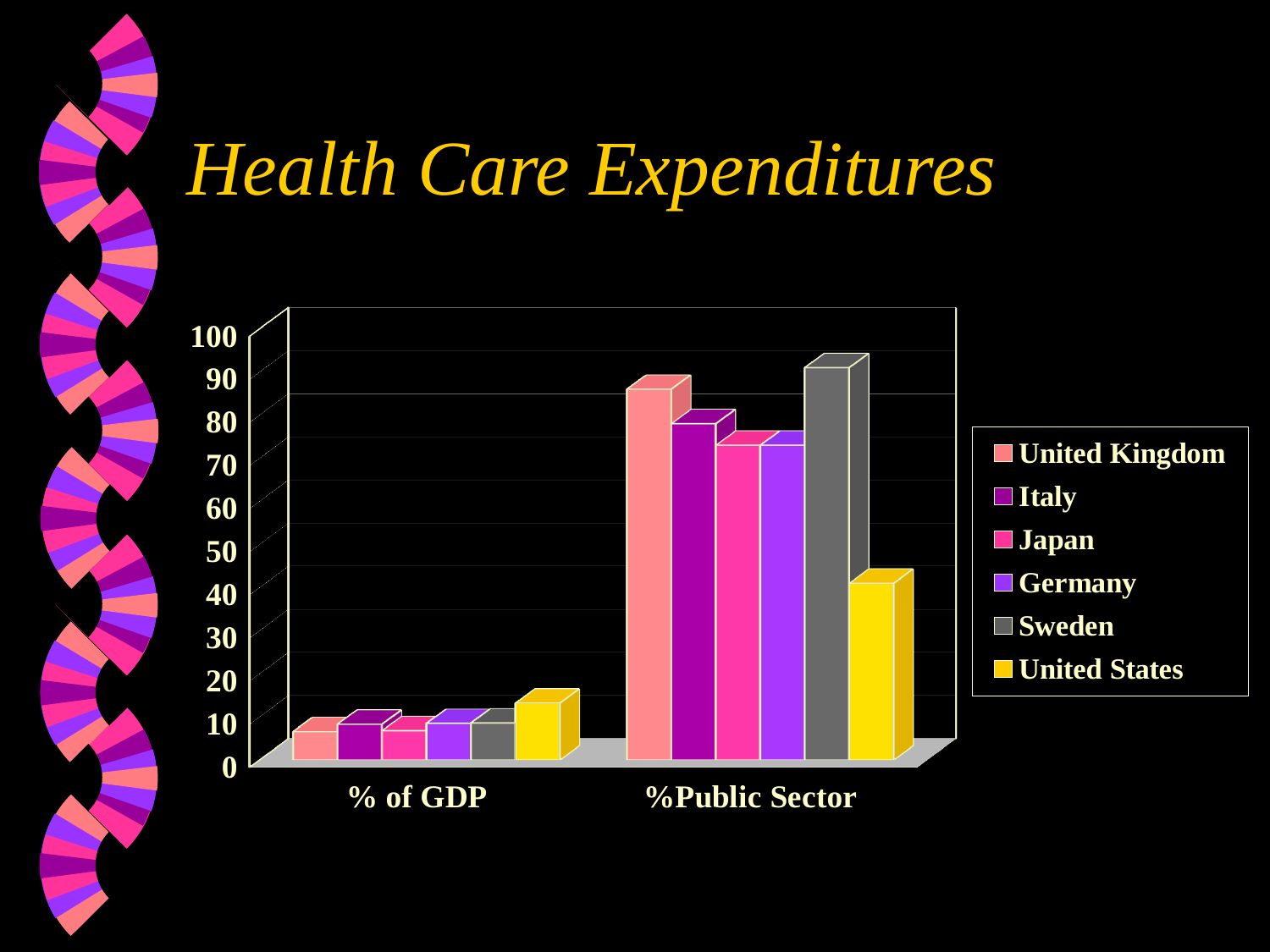
Which is larger for %Public Sector: the United Kingdom or the United States? United Kingdom Is the value for Sweden in %Public Sector greater or less than 80? greater Which country has the lowest value for %Public Sector? United States How many series does the legend list? 6 How many categories are shown on the x axis of the chart? 2 Which country has the highest value for % of GDP? United States What kind of chart is shown on the slide? bar chart Is the value for the United States in %Public Sector greater or less than 50? less What is the title of the slide? Health Care Expenditures Is the value for the United States in % of GDP greater or less than 20? less Which country has the highest value for %Public Sector? Sweden Which country is shown in yellow in the legend? United States